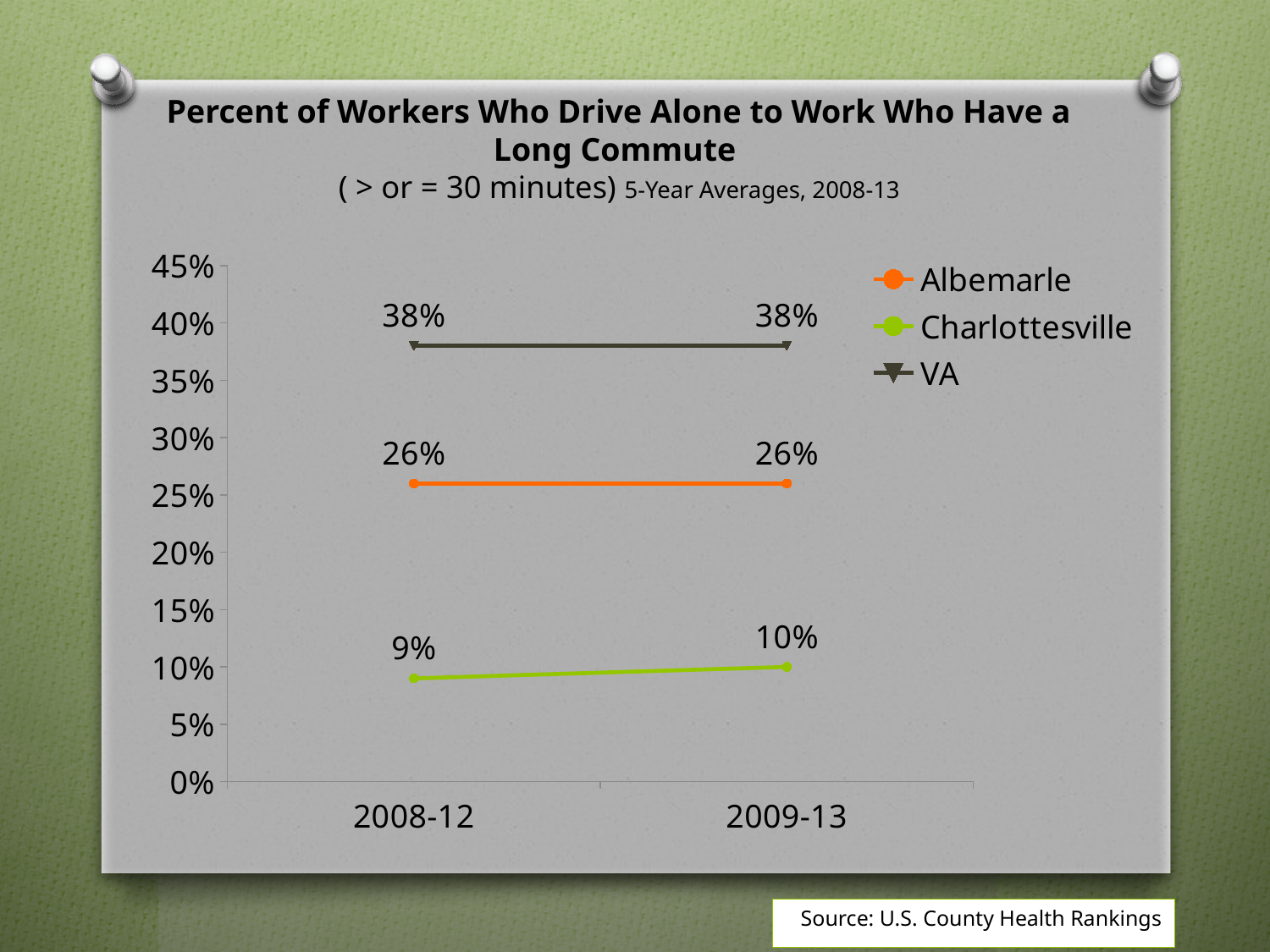
Which series has the highest value in 2008-12? VA Which is larger, the Albemarle value in 2008-12 or the Charlottesville value in 2008-12? Albemarle What is the value for Albemarle in 2008-12? 26% Which series has the lowest value in 2009-13? Charlottesville What is the value for VA in 2009-13? 38% What is the value for Charlottesville in 2009-13? 10% How many series does the legend list? 3 What kind of chart is this? Line chart How many time periods are shown on the x axis? 2 Does the Charlottesville value rise or fall from 2008-12 to 2009-13? Rise What is the source cited for the chart? U.S. County Health Rankings What is the difference between the VA and Albemarle values in 2009-13? 12%